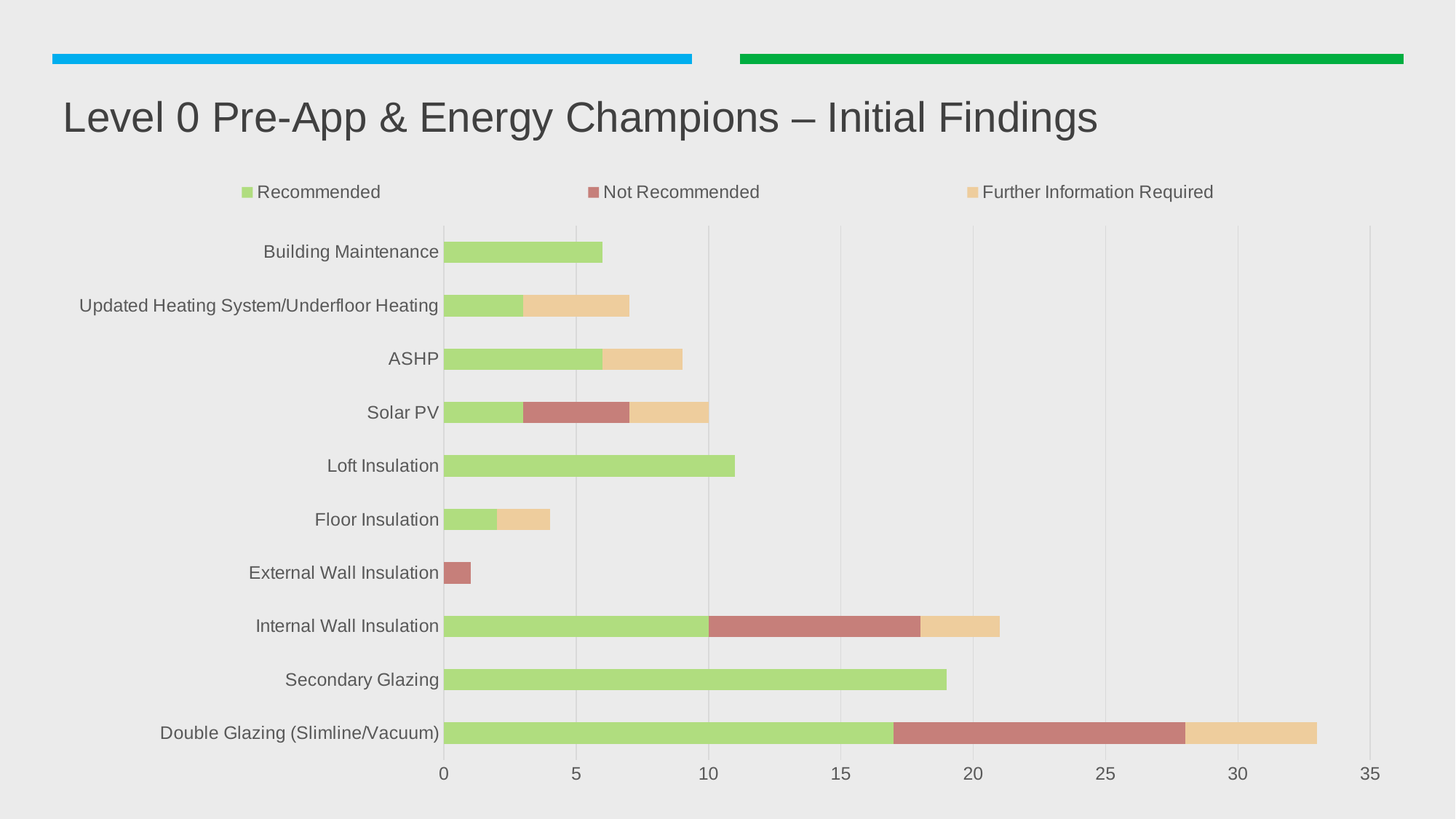
Which category has the shortest total bar? External Wall Insulation How many categories are listed on the vertical axis of the chart? 10 Which category has the longest total bar? Double Glazing (Slimline/Vacuum) Which category's bar consists only of the Not Recommended series? External Wall Insulation Is the total bar for Double Glazing (Slimline/Vacuum) greater or less than 30? greater Is the total bar for External Wall Insulation greater or less than 5? less Is the total bar for Secondary Glazing greater or less than 15? greater How many series does the chart legend list? 3 What kind of chart is shown on the slide? Stacked bar chart Which has the longer total bar, Building Maintenance or Floor Insulation? Building Maintenance Which series is shown in green in the chart legend? Recommended